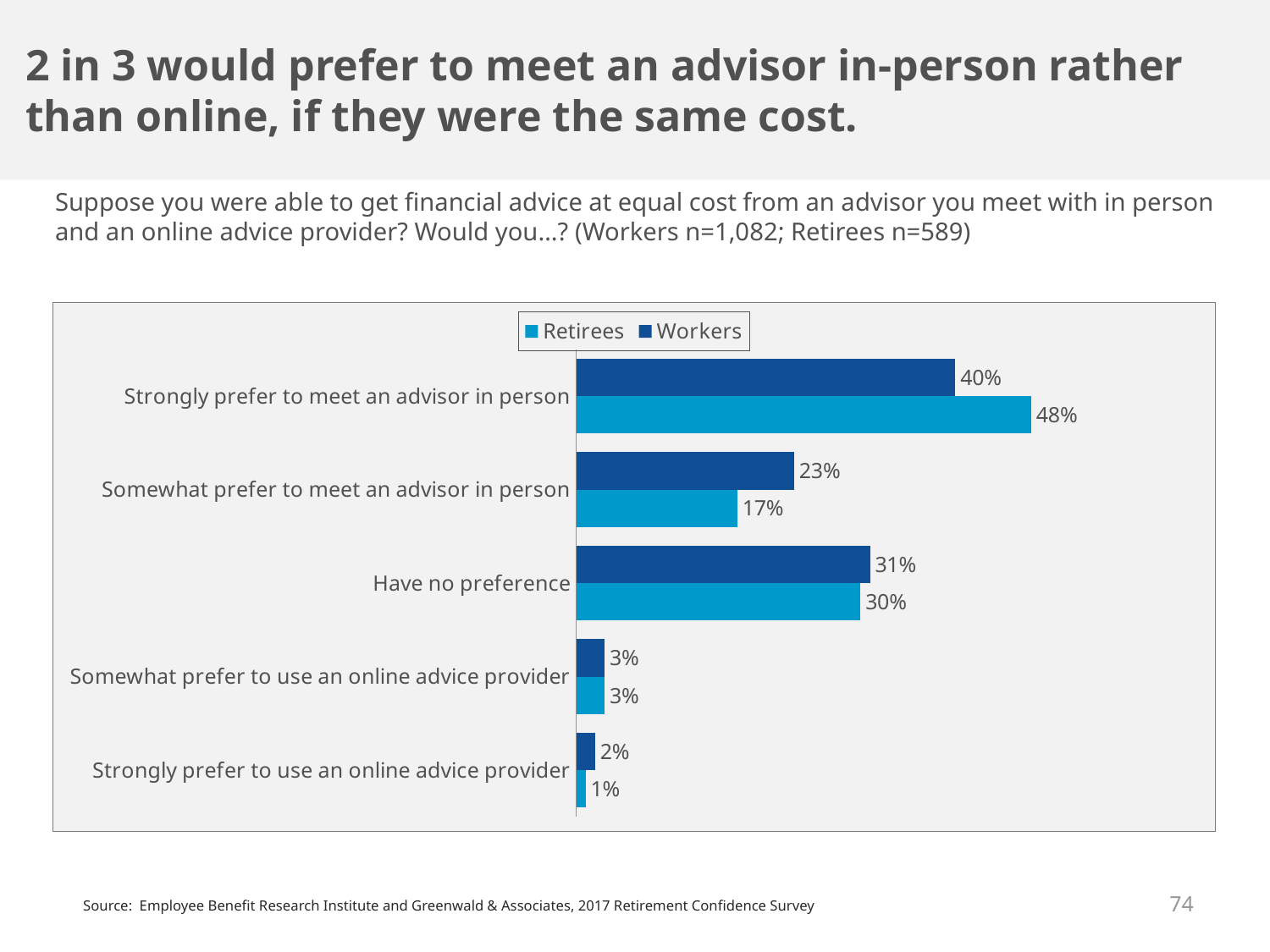
How many series does the legend list? 2 Which category has the highest value for Retirees? Strongly prefer to meet an advisor in person What percentage of Workers somewhat prefer to meet an advisor in person? 23% What is the difference between the Retirees and Workers values for 'Strongly prefer to meet an advisor in person'? 8% For 'Somewhat prefer to meet an advisor in person', which group has the larger value, Workers or Retirees? Workers What percentage of Workers strongly prefer to use an online advice provider? 2% What kind of chart is shown on the slide? Bar chart What percentage of Retirees strongly prefer to meet an advisor in person? 48% What percentage of Retirees have no preference? 30% What percentage of Workers strongly prefer to meet an advisor in person? 40% How many response categories are shown in the chart? 5 Which category has the lowest value for Retirees? Strongly prefer to use an online advice provider